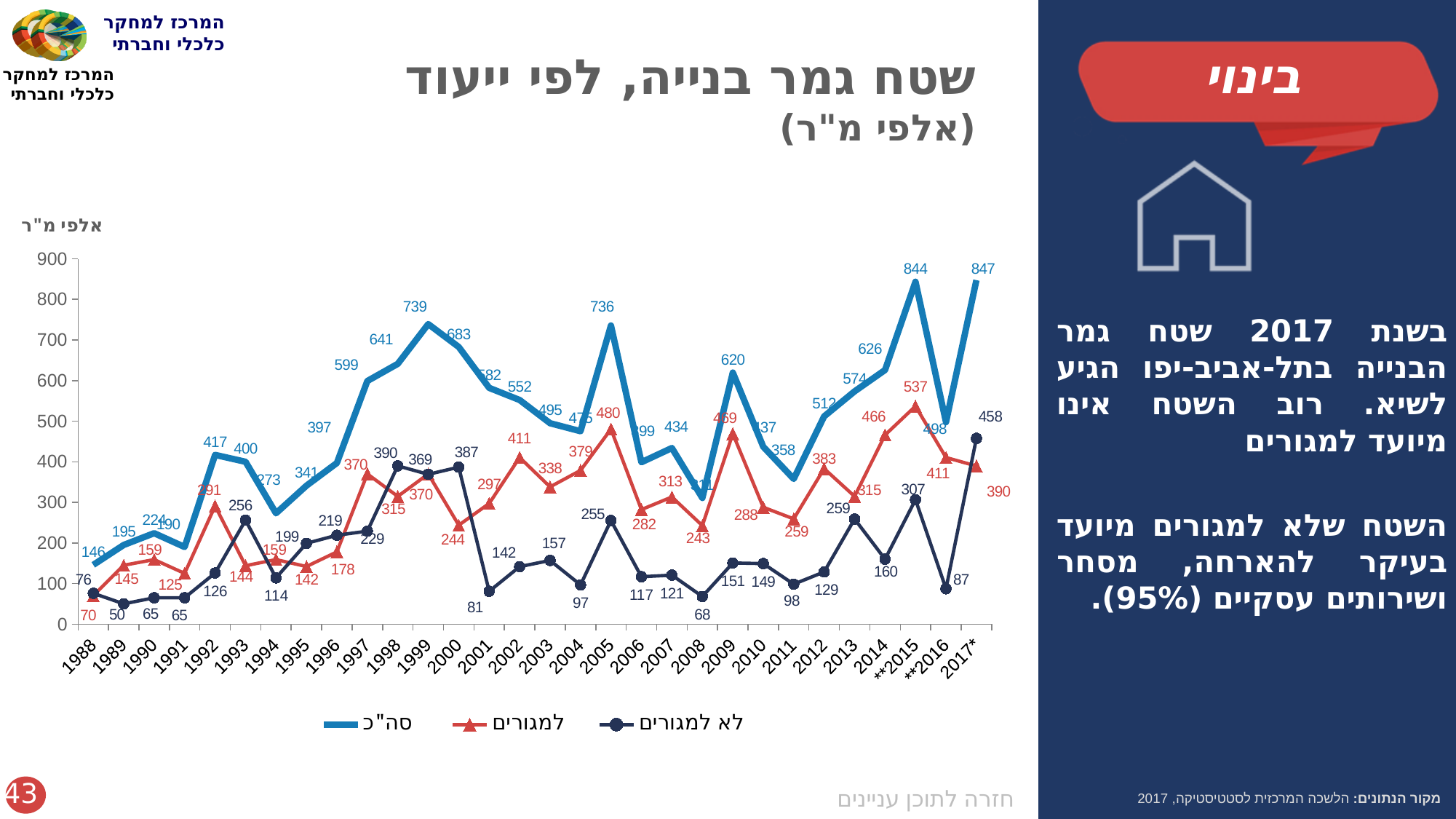
Does the סה"כ series rise or fall from 2011 to 2015? rise What is the value of the סה"כ series for 2017*? 847 What is the value of the למגורים series in 2005? 480 How many years are shown on the x axis? 30 What is the difference between the סה"כ value and the למגורים value in 2017*? 457 What is the value of the לא למגורים series in 2017*? 458 In which year is the לא למגורים series at its lowest? 1989 What kind of chart is shown on the slide? line chart In 2015, which is larger: the למגורים value or the לא למגורים value? למגורים In which year does the סה"כ series reach its highest value? 2017* In which year does the למגורים series reach its highest value? 2015 How many series does the legend list? 3